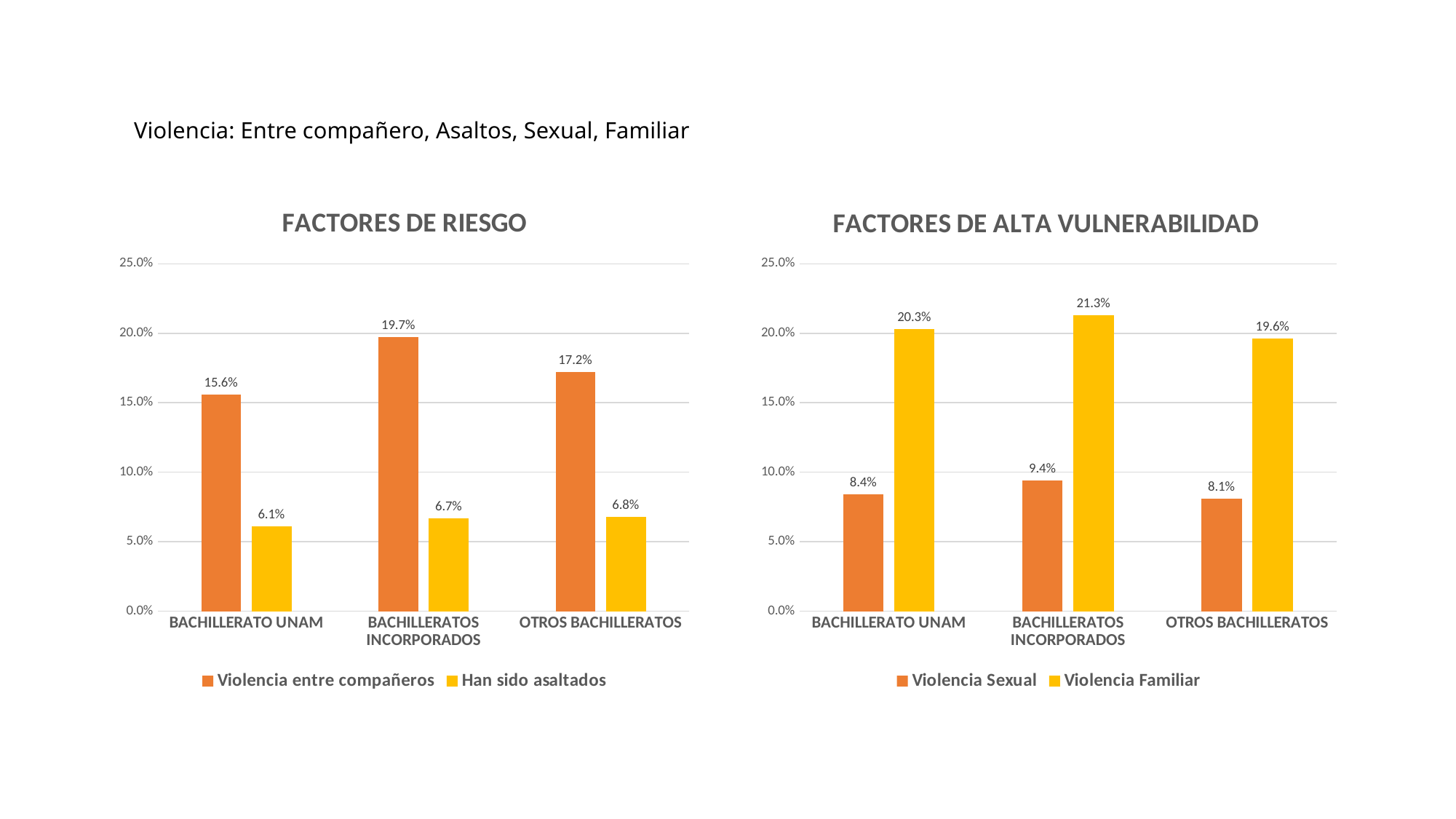
In the FACTORES DE RIESGO chart, how many series does the legend list? 2 In the FACTORES DE RIESGO chart, what is the value of Violencia entre compañeros for BACHILLERATOS INCORPORADOS? 19.7% In the FACTORES DE RIESGO chart, what is the difference between Violencia entre compañeros and Han sido asaltados for OTROS BACHILLERATOS? 10.4% How many categories are shown on the x axis of the FACTORES DE RIESGO chart? 3 In the FACTORES DE ALTA VULNERABILIDAD chart, what is the value of Violencia Sexual for OTROS BACHILLERATOS? 8.1% In the FACTORES DE RIESGO chart, what is the value of Han sido asaltados for BACHILLERATO UNAM? 6.1% In the FACTORES DE RIESGO chart, which category has the highest value for Violencia entre compañeros? BACHILLERATOS INCORPORADOS In the FACTORES DE ALTA VULNERABILIDAD chart, which is larger for BACHILLERATO UNAM: Violencia Sexual or Violencia Familiar? Violencia Familiar In the FACTORES DE ALTA VULNERABILIDAD chart, what is the value of Violencia Familiar for BACHILLERATOS INCORPORADOS? 21.3% In the FACTORES DE ALTA VULNERABILIDAD chart, what is the difference between Violencia Familiar and Violencia Sexual for BACHILLERATO UNAM? 11.9% What kind of chart is the FACTORES DE ALTA VULNERABILIDAD chart? Bar chart In the FACTORES DE ALTA VULNERABILIDAD chart, which category has the lowest value for Violencia Familiar? OTROS BACHILLERATOS